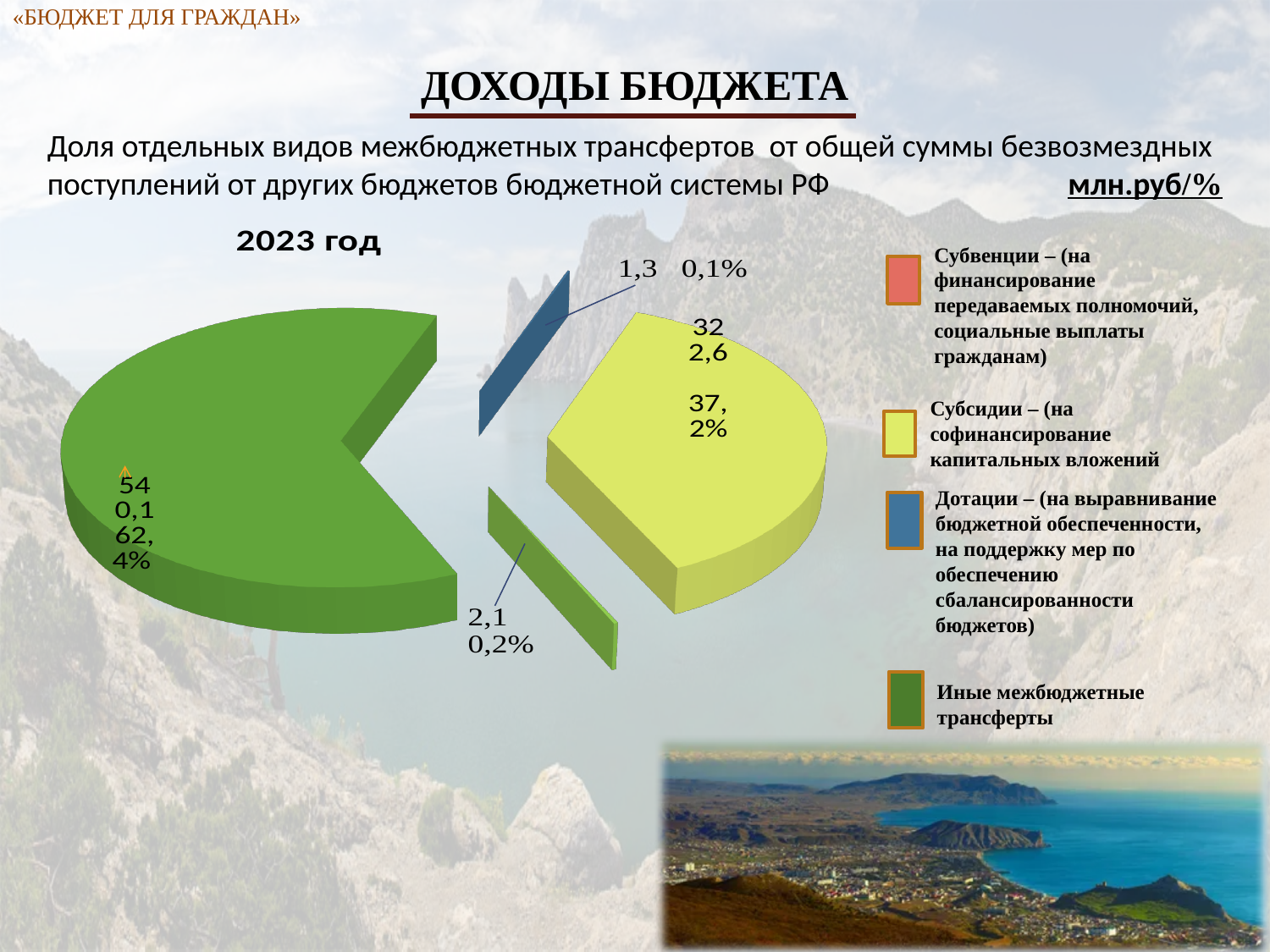
What kind of chart is shown on the slide? pie chart What value in млн.руб is shown for Субсидии (the yellow slice)? 322,6 What value in млн.руб is shown for Дотации (the blue slice)? 1,3 What is the value of the smallest slice in the pie chart? 1,3 What is the difference between the value for Субсидии and the value for Дотации? 321,3 Which is larger, the value for Субсидии or the value for Дотации? Субсидии What share of the pie does Дотации (the blue slice) have? 0,1% What is the share of the largest slice in the pie chart? 62,4% What share of the pie does Субсидии (the yellow slice) have? 37,2% How many entries does the legend list? 4 What is the title shown above the pie chart? 2023 год How many slices does the pie chart have? 4